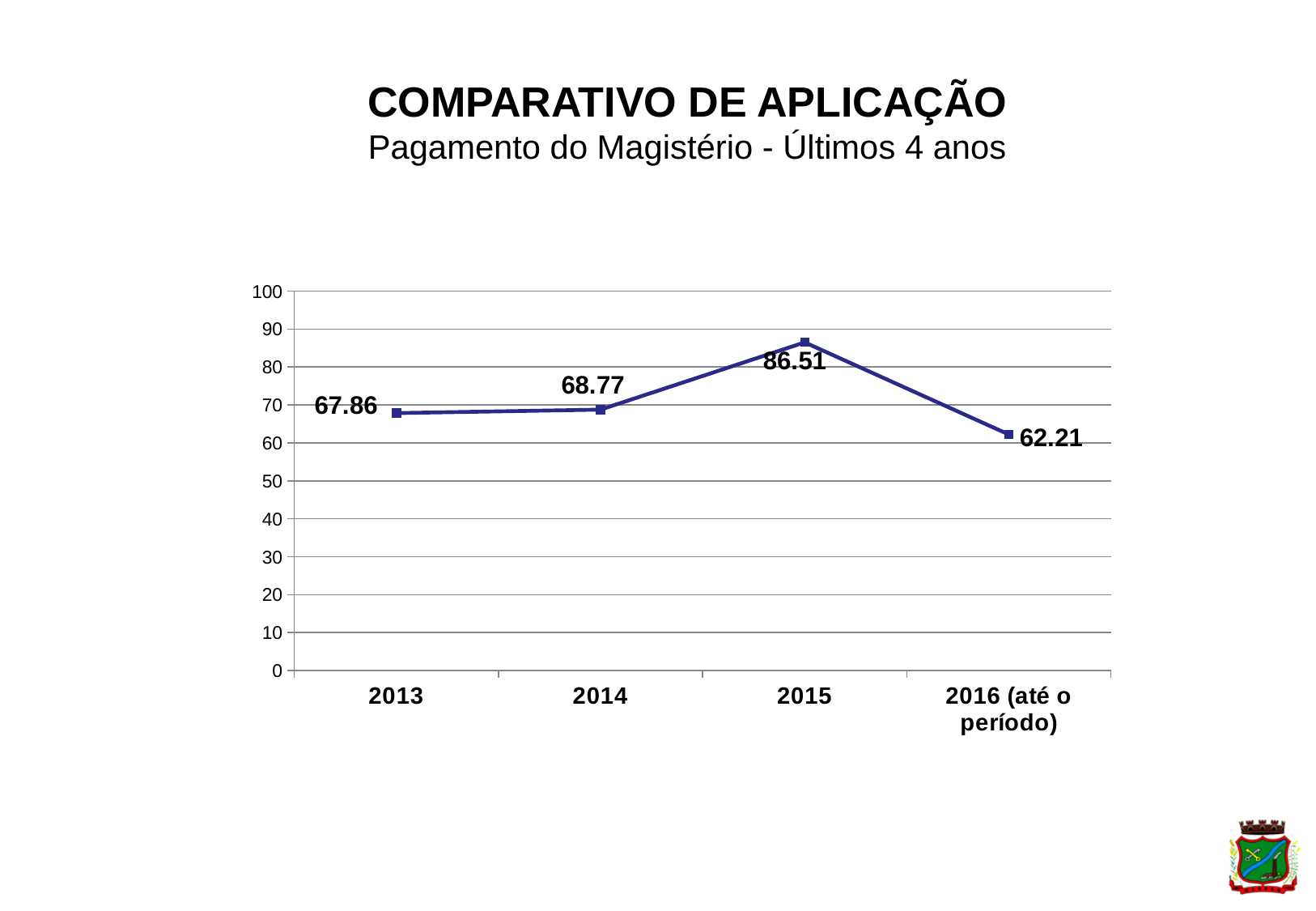
Does the value rise or fall from 2015 to 2016 (até o período)? fall Which is larger, the value for 2013 or the value for 2014? 2014 What kind of chart is shown on the slide? line chart What is the difference between the values for 2015 and 2014? 17.74 What is the subtitle of the chart below 'COMPARATIVO DE APLICAÇÃO'? Pagamento do Magistério - Últimos 4 anos Which year has the highest value? 2015 What is the value for 2016 (até o período)? 62.21 Is the value for 2015 greater or less than 80? greater What is the value for 2013? 67.86 What is the value for 2015? 86.51 Which category has the lowest value? 2016 (até o período) How many data points are plotted on the chart? 4